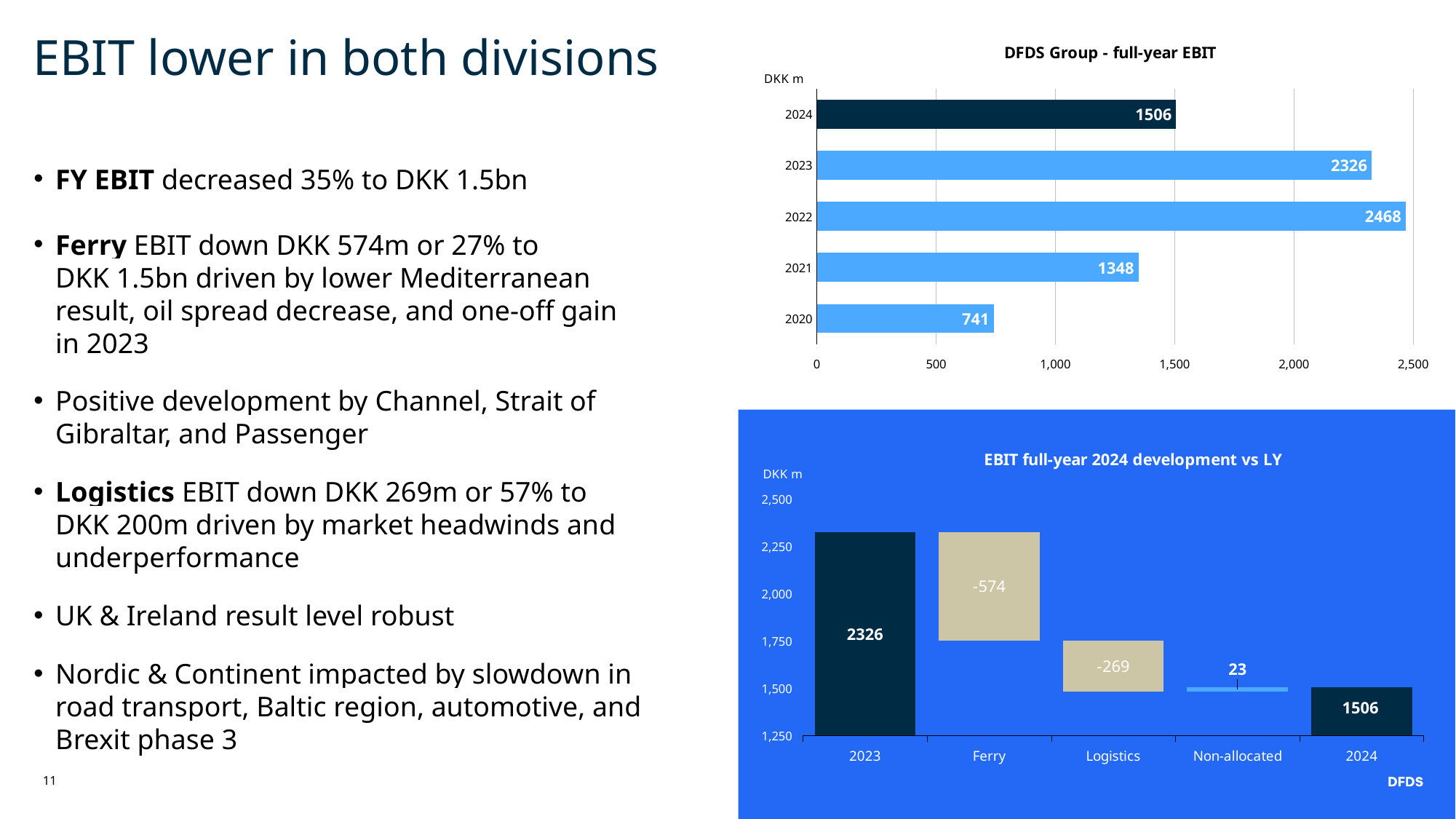
What unit is shown on the axis of the 'DFDS Group - full-year EBIT' chart? DKK m In the 'DFDS Group - full-year EBIT' chart, what is the value for 2020? 741 In the 'EBIT full-year 2024 development vs LY' chart, what is the value for Ferry? -574 What kind of chart is the 'DFDS Group - full-year EBIT' chart? Bar chart In the 'EBIT full-year 2024 development vs LY' chart, what is the value for Non-allocated? 23 In the 'DFDS Group - full-year EBIT' chart, what is the value for 2024? 1506 In the 'DFDS Group - full-year EBIT' chart, which year has the highest EBIT? 2022 In the 'DFDS Group - full-year EBIT' chart, which is larger, the value for 2021 or the value for 2024? 2024 In the 'DFDS Group - full-year EBIT' chart, what is the difference between the 2023 and 2024 values? 820 In the 'DFDS Group - full-year EBIT' chart, how many years are shown? 5 In the 'EBIT full-year 2024 development vs LY' chart, what is the value for Logistics? -269 In the 'DFDS Group - full-year EBIT' chart, which year has the lowest EBIT? 2020